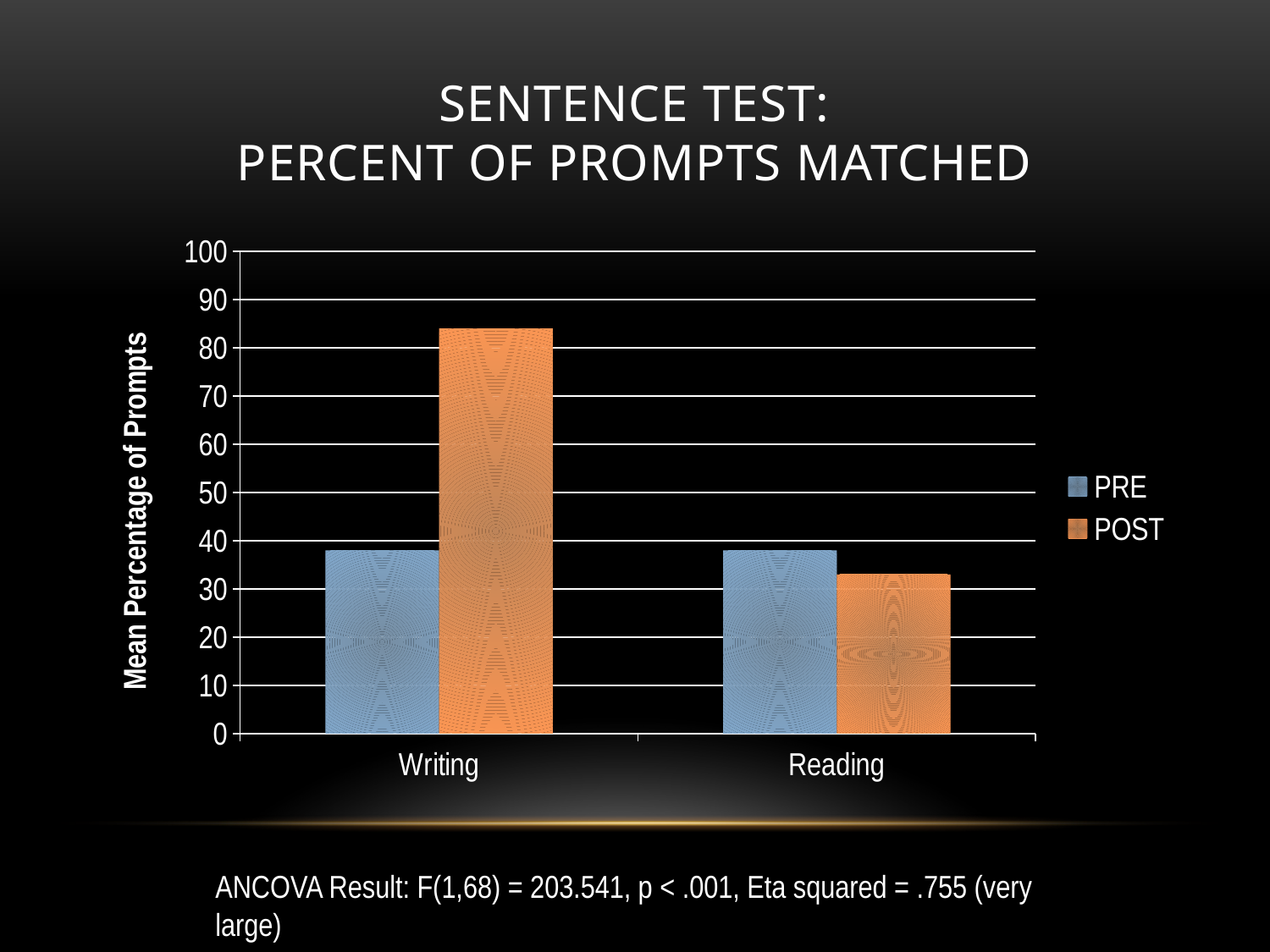
Is the POST value for Writing greater or less than 70? greater What is the label of the y axis? Mean Percentage of Prompts How many series does the legend list? 2 Is the POST value for Reading greater or less than 40? less For Reading, which is larger, the PRE value or the POST value? PRE Is the PRE value for Writing greater or less than 30? greater Which bar is the lowest in the chart? Reading POST How many categories are shown on the x axis? 2 For Writing, which is larger, the PRE value or the POST value? POST What kind of chart is shown on the slide? bar chart Which bar is the highest in the chart? Writing POST